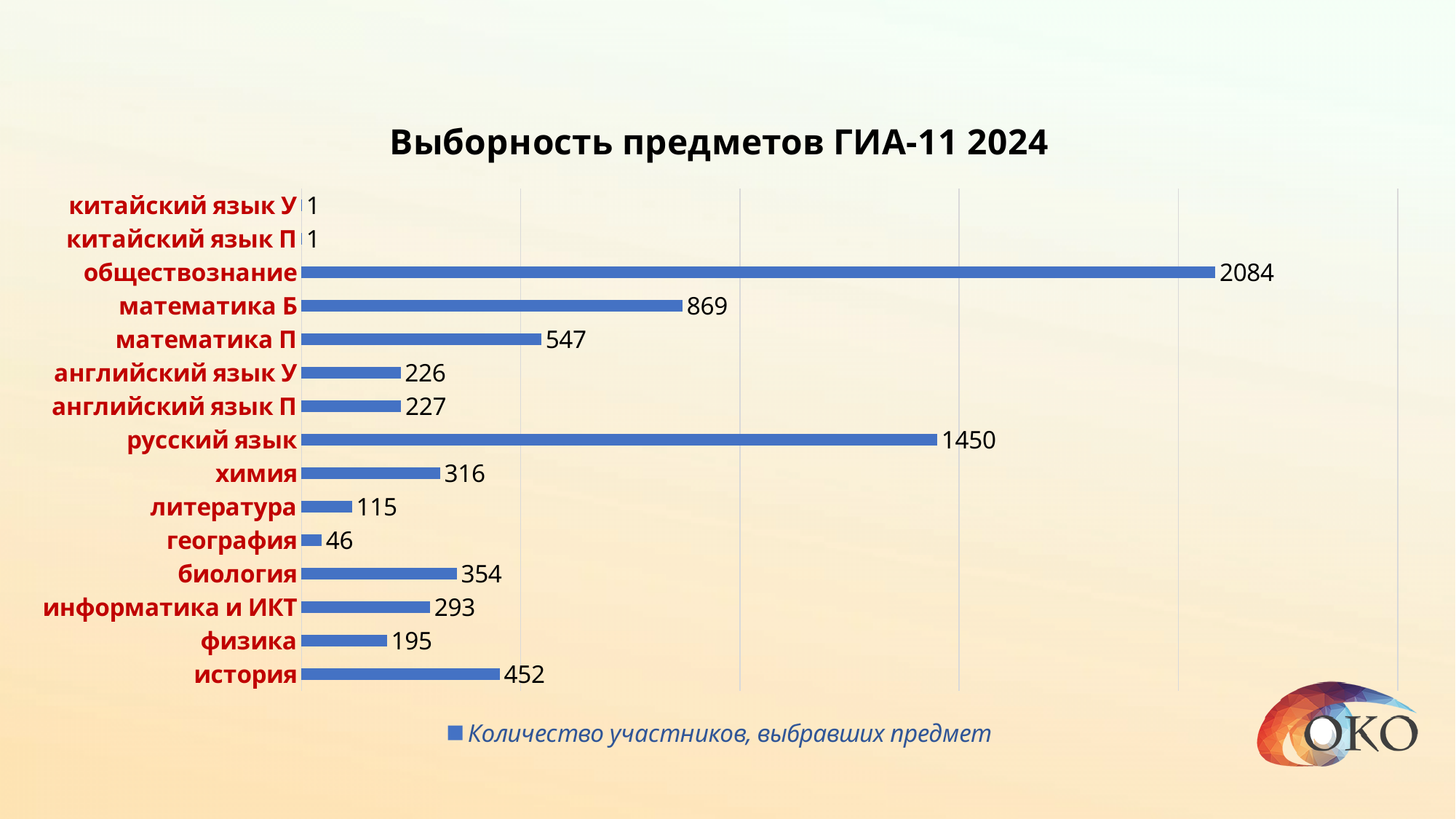
What is the title of the chart? Выборность предметов ГИА-11 2024 What is the value for информатика и ИКТ? 293 What is the value for русский язык? 1450 Which subject has the highest value? обществознание What is the difference between the values for обществознание and русский язык? 634 What is the value for география? 46 How many series does the legend list? 1 Which is larger, the value for математика Б or the value for математика П? математика Б What kind of chart is shown on the slide? bar chart What is the value for обществознание? 2084 What is the difference between the values for история and физика? 257 How many categories (subjects) are shown in the chart? 15